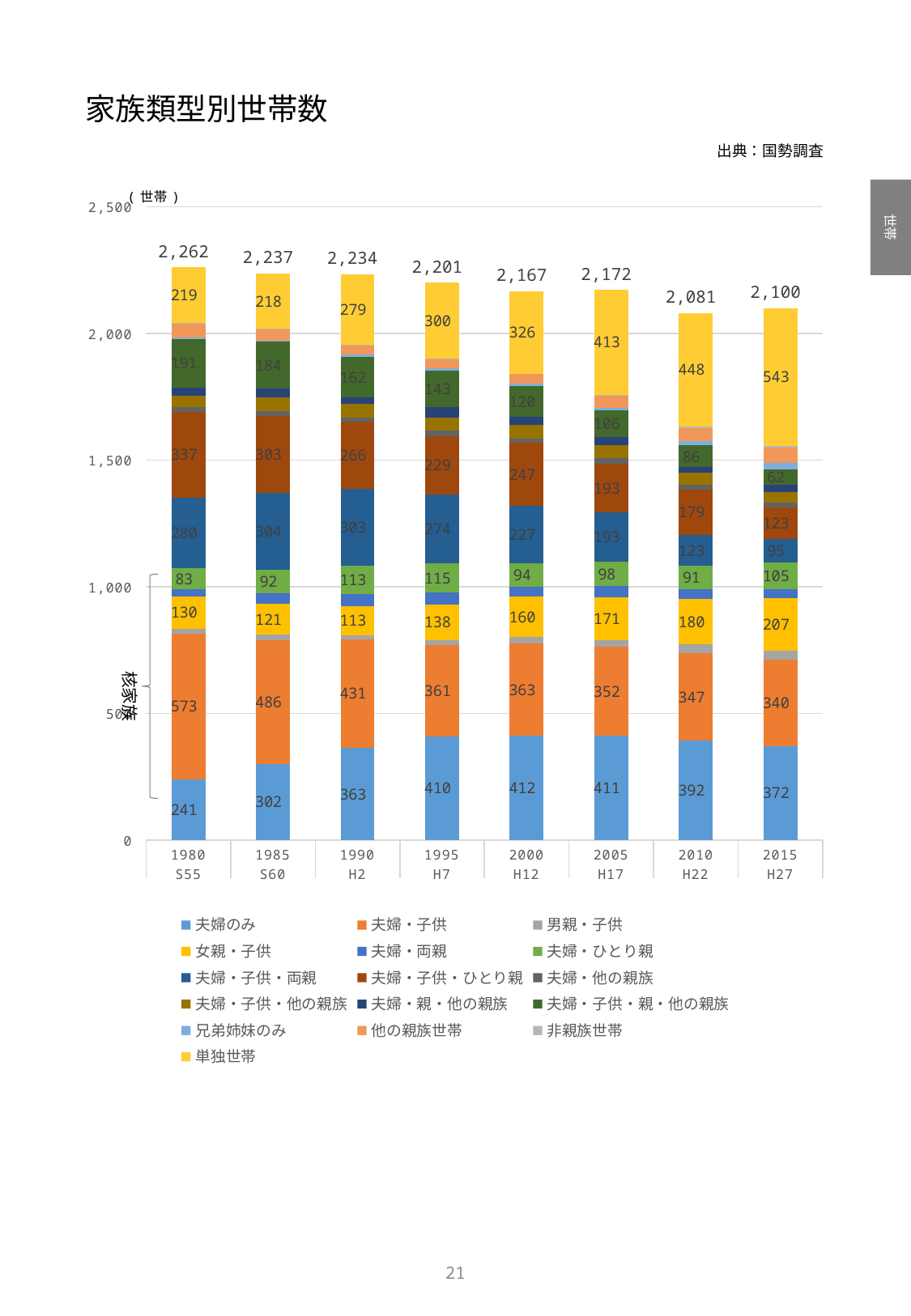
What kind of chart is shown on the slide? stacked bar chart What is the total number of households shown above the bar for 1980 (S55)? 2,262 What is the source (出典) of the data shown on the slide? 国勢調査 What is the value of 単独世帯 in 2015 (H27)? 543 Does the 夫婦・子供 value rise or fall from 1980 to 2015? fall Which is larger, the 単独世帯 value in 2010 (H22) or in 2015 (H27)? 2015 (H27) What is the difference between the 夫婦のみ value in 2000 (H12) and in 1980 (S55)? 171 What is the value of 夫婦・子供 in 1980 (S55)? 573 Which year has the lowest total number of households? 2010 (H22) How many years (categories) are shown on the x axis? 8 Which year has the highest total number of households? 1980 (S55) How many series does the legend list? 16